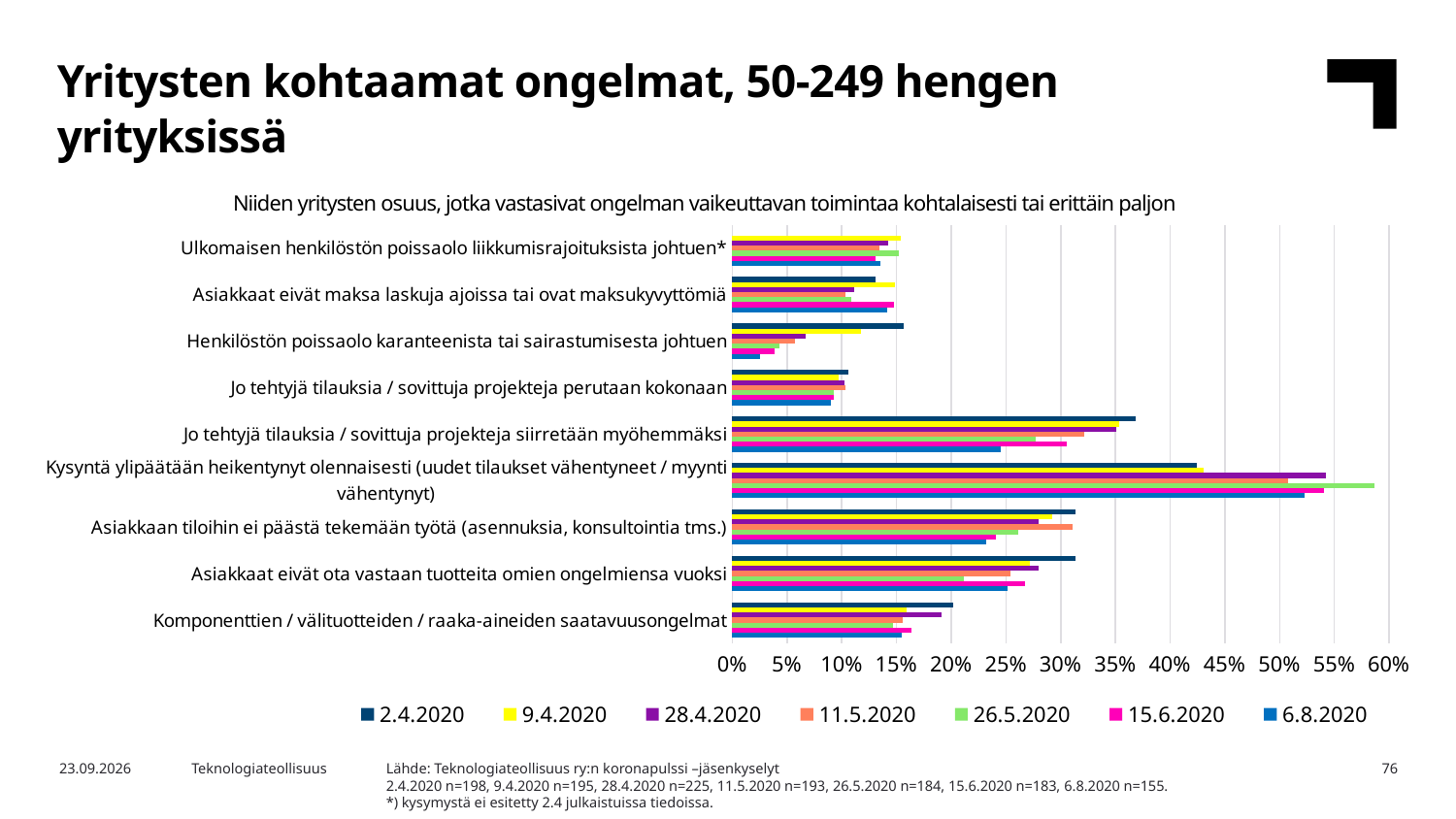
What is the first series listed in the legend? 2.4.2020 Is the 26.5.2020 value for 'Kysyntä ylipäätään heikentynyt olennaisesti' greater or less than 55%? greater For 'Kysyntä ylipäätään heikentynyt olennaisesti', which is larger: the 26.5.2020 value or the 2.4.2020 value? 26.5.2020 Is the 2.4.2020 value for 'Asiakkaan tiloihin ei päästä tekemään työtä' greater or less than 30%? greater For 'Jo tehtyjä tilauksia / sovittuja projekteja siirretään myöhemmäksi', which is larger: the 2.4.2020 value or the 6.8.2020 value? 2.4.2020 Is the 6.8.2020 value for 'Henkilöstön poissaolo karanteenista tai sairastumisesta johtuen' greater or less than 5%? less How many series does the legend list? 7 How many problem categories are plotted on the chart? 9 Which category has the highest values across the series? Kysyntä ylipäätään heikentynyt olennaisesti (uudet tilaukset vähentyneet / myynti vähentynyt) For the 6.8.2020 series, which category has the lowest value? Henkilöstön poissaolo karanteenista tai sairastumisesta johtuen What kind of chart is shown on the slide? Bar chart